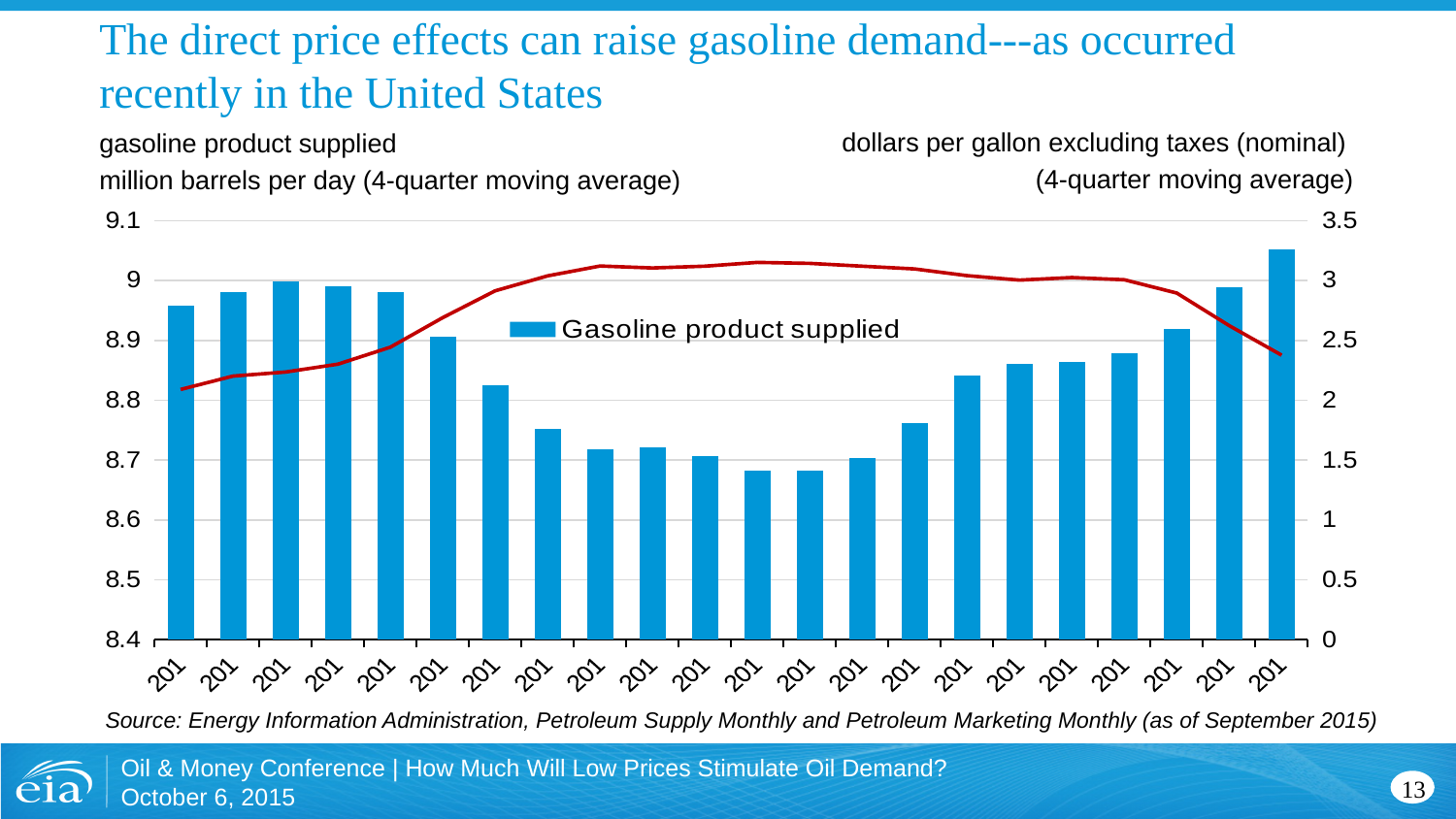
What is the unit shown for the left axis? million barrels per day (4-quarter moving average) How many series does the legend list? 1 How do the bar values change from left to right across the chart? They fall to a low in the middle and then rise again Is the value of the first (leftmost) bar greater or less than 8.9? greater Is the rightmost bar taller or shorter than the leftmost bar? taller Is the value of the rightmost bar greater or less than 9? greater Is the red line's value at the right end of the chart greater or less than 3 on the right axis? less How many bars are plotted in the chart? 22 Which bar is the tallest in the chart? The rightmost (last) bar What kind of chart is shown on the slide? A bar chart combined with a line What series name appears in the legend? Gasoline product supplied